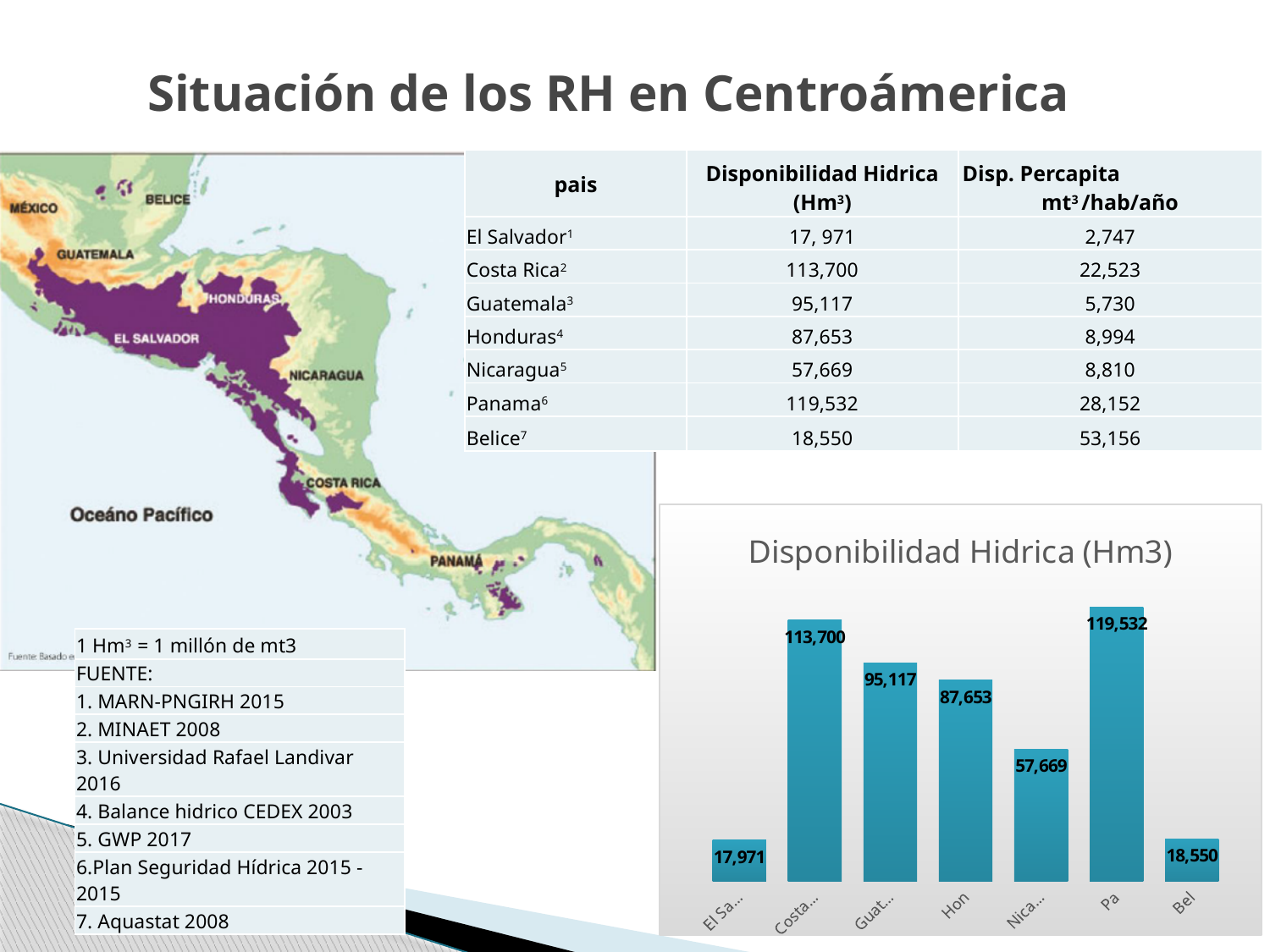
In the Disponibilidad Hidrica (Hm3) chart, what is the value for Costa Rica? 113,700 How many bars are plotted in the Disponibilidad Hidrica (Hm3) chart? 7 In the Disponibilidad Hidrica (Hm3) chart, what is the difference between the values for Guatemala and Honduras? 7,464 Which country has the lowest bar in the Disponibilidad Hidrica (Hm3) chart? El Salvador In the Disponibilidad Hidrica (Hm3) chart, what is the difference between the values for Panama and Costa Rica? 5,832 What is the title of the chart on the slide? Disponibilidad Hidrica (Hm3) In the Disponibilidad Hidrica (Hm3) chart, which is larger, the value for Guatemala or the value for Nicaragua? Guatemala In the Disponibilidad Hidrica (Hm3) chart, which is larger, the value for Belice or the value for El Salvador? Belice In the Disponibilidad Hidrica (Hm3) chart, what is the value for Honduras? 87,653 What type of chart is shown on the slide? bar chart In the Disponibilidad Hidrica (Hm3) chart, what is the value for Nicaragua? 57,669 Which country has the highest bar in the Disponibilidad Hidrica (Hm3) chart? Panama